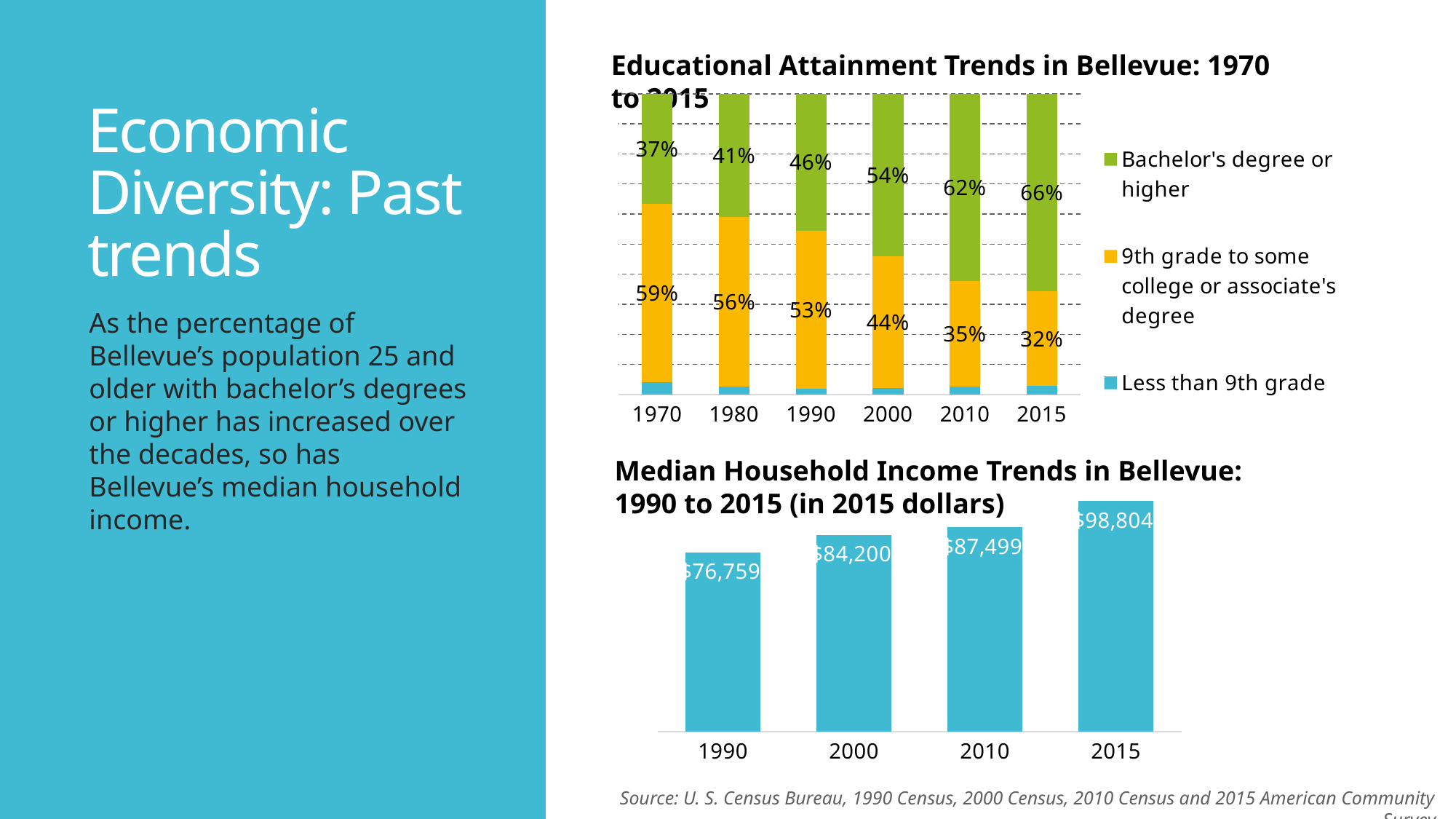
In the Median Household Income Trends chart, what was the median household income in 2010? $87,499 In the Median Household Income Trends chart, how many years are shown on the x axis? 4 In the Educational Attainment Trends chart, does the bachelor's degree or higher share rise or fall from 1970 to 2015? Rise In the Educational Attainment Trends chart, how many series does the legend list? 3 In the Median Household Income Trends chart, what was Bellevue's median household income in 1990? $76,759 What kind of chart is the Median Household Income Trends chart? Bar chart In the Educational Attainment Trends chart, what percentage had 9th grade to some college or associate's degree in 1970? 59% In the Educational Attainment Trends chart, what percentage of Bellevue's population had a bachelor's degree or higher in 2015? 66% In the Median Household Income Trends chart, what is the difference between the 2015 and 2000 values? $14,604 In the Educational Attainment Trends chart, which year has the lowest share with 9th grade to some college or associate's degree? 2015 In the Educational Attainment Trends chart, which year has the highest share with a bachelor's degree or higher? 2015 In the Educational Attainment Trends chart, by how many percentage points did the bachelor's degree or higher share increase from 1970 to 2015? 29 percentage points